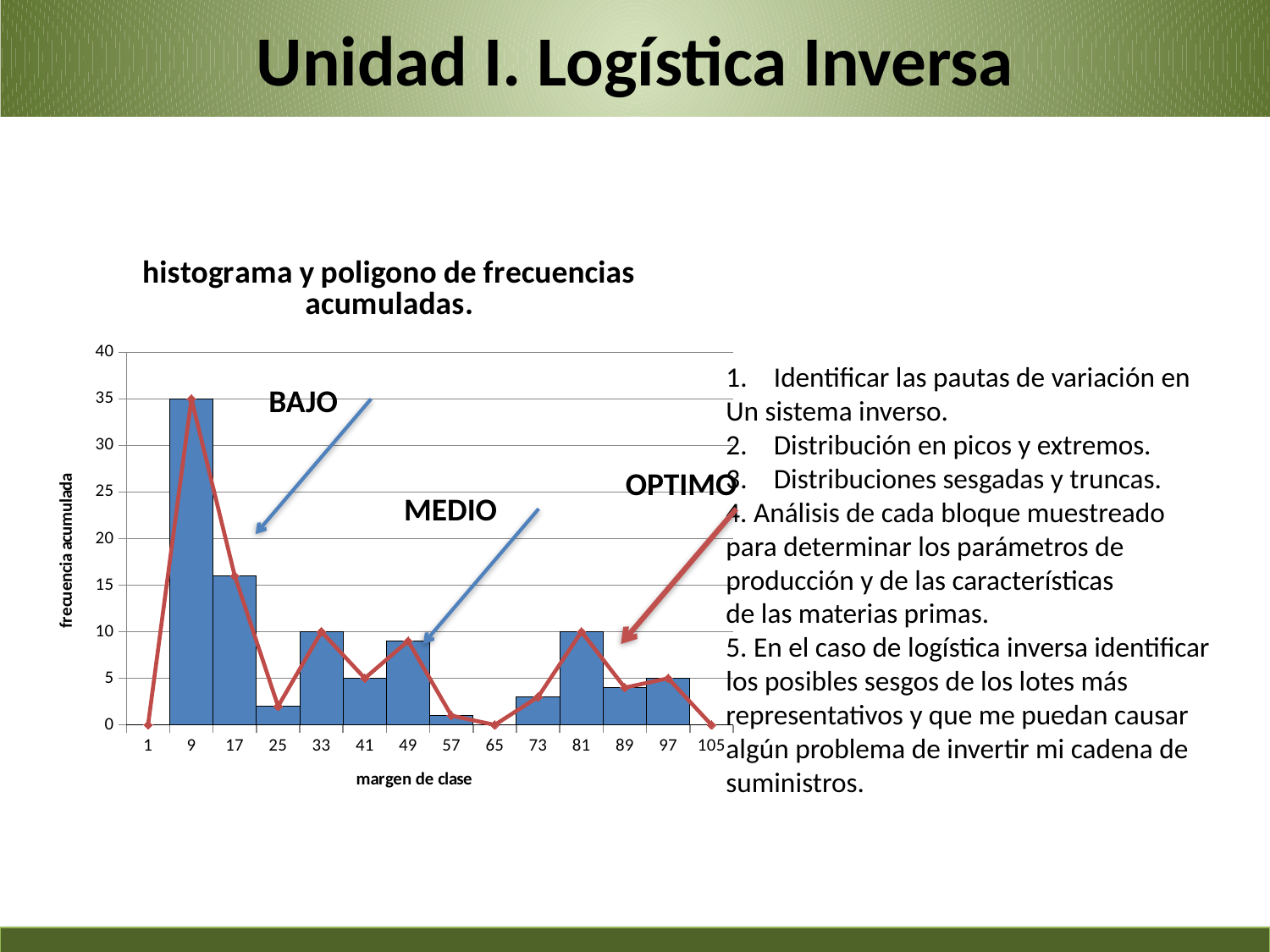
What is the frecuencia acumulada for margen de clase 9? 35 Which is larger, the frecuencia acumulada for margen de clase 9 or for margen de clase 17? 9 What kind of chart is shown on the slide? bar chart with a line What is the label of the vertical axis? frecuencia acumulada What is the frecuencia acumulada for margen de clase 33? 10 What is the frecuencia acumulada for margen de clase 81? 10 What is the title of the chart? histograma y poligono de frecuencias acumuladas. What is the frecuencia acumulada for margen de clase 41? 5 Is the frecuencia acumulada for margen de clase 25 greater or less than 5? less Is the frecuencia acumulada for margen de clase 17 greater or less than 15? greater What is the difference between the frecuencia acumulada for margen de clase 9 and for margen de clase 33? 25 Which margen de clase has the highest frecuencia acumulada? 9